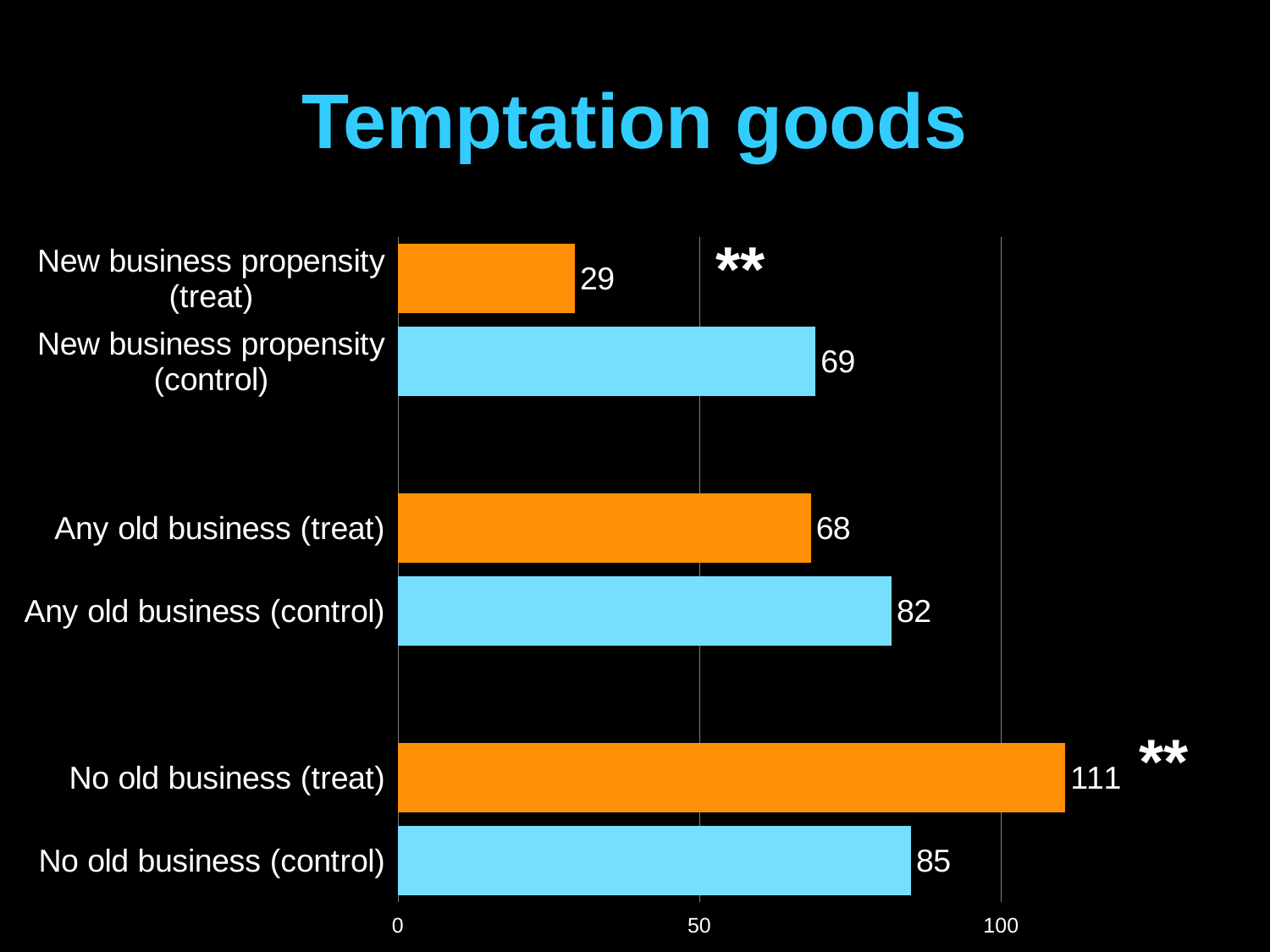
Is the value for No old business (treat) greater or less than 100? greater What is the difference between New business propensity (control) and New business propensity (treat)? 40 Which category has the highest value? No old business (treat) What is the value for Any old business (control)? 82 What is the value for New business propensity (treat)? 29 Which category has the lowest value? New business propensity (treat) Which is larger, Any old business (treat) or Any old business (control)? Any old business (control) What is the title of the chart? Temptation goods What kind of chart is shown on the slide? Bar chart How many bars are shown in the chart? 6 What is the value for No old business (control)? 85 What is the difference between No old business (treat) and No old business (control)? 26